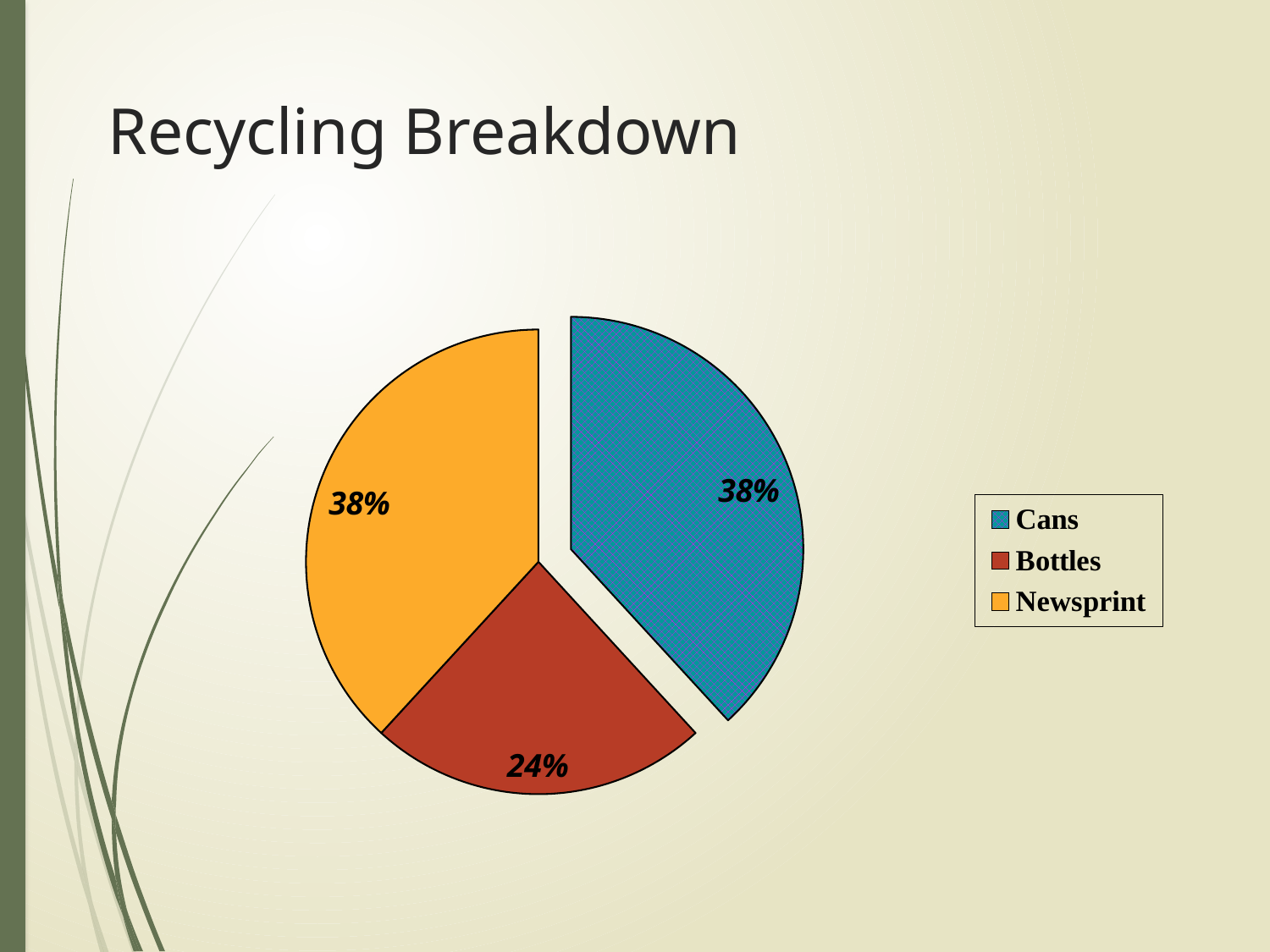
What is the combined share of Cans and Newsprint? 76% What percentage of the pie does Newsprint account for? 38% Which category has the smallest share of the pie? Bottles Which slice is pulled out (exploded) from the rest of the pie? Cans What percentage of the pie does Cans account for? 38% Which is larger, the share for Cans or the share for Bottles? Cans What percentage of the pie does Bottles account for? 24% How many slices does the pie chart have? 3 What kind of chart is shown on the slide? Pie chart What is the title of the slide containing the chart? Recycling Breakdown How many entries does the legend list? 3 What is the difference between the share for Newsprint and the share for Bottles? 14%